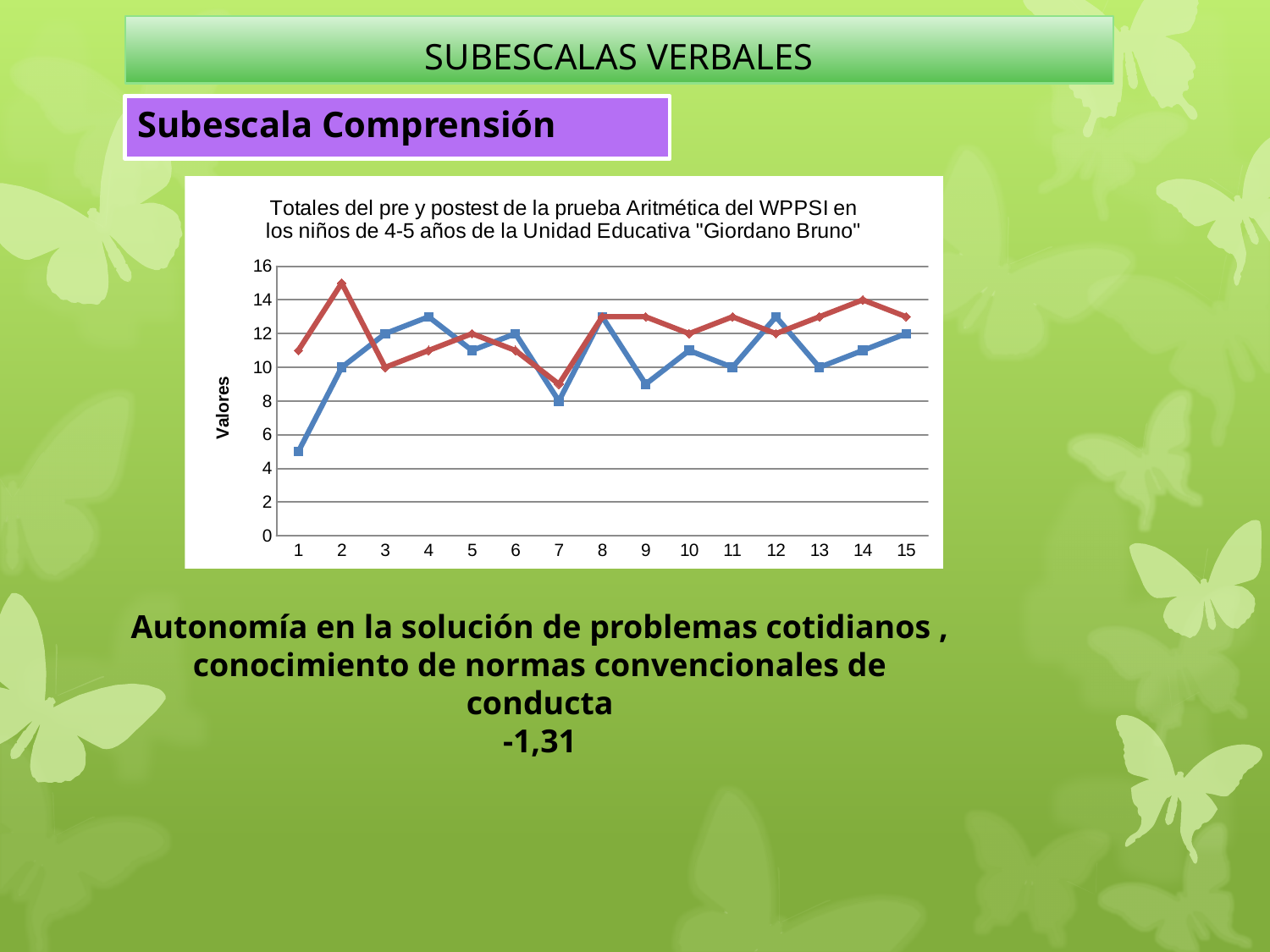
At point 1, which line has the higher value, the red line or the blue line? red line At which x-axis point does the red line reach its highest value? 2 What is the label of the vertical axis of the chart? Valores What kind of chart is shown on the slide? line chart Is the value of the red line at point 2 greater or less than 14? greater How many lines are plotted in the chart? 2 At point 9, which line has the higher value, the red line or the blue line? red line Is the value of the blue line at point 1 greater or less than 6? less Is the value of the blue line at point 7 greater or less than 10? less At which x-axis point does the blue line reach its lowest value? 1 What is the value of the blue line at point 2? 10 How many points are plotted along the x axis of the chart? 15